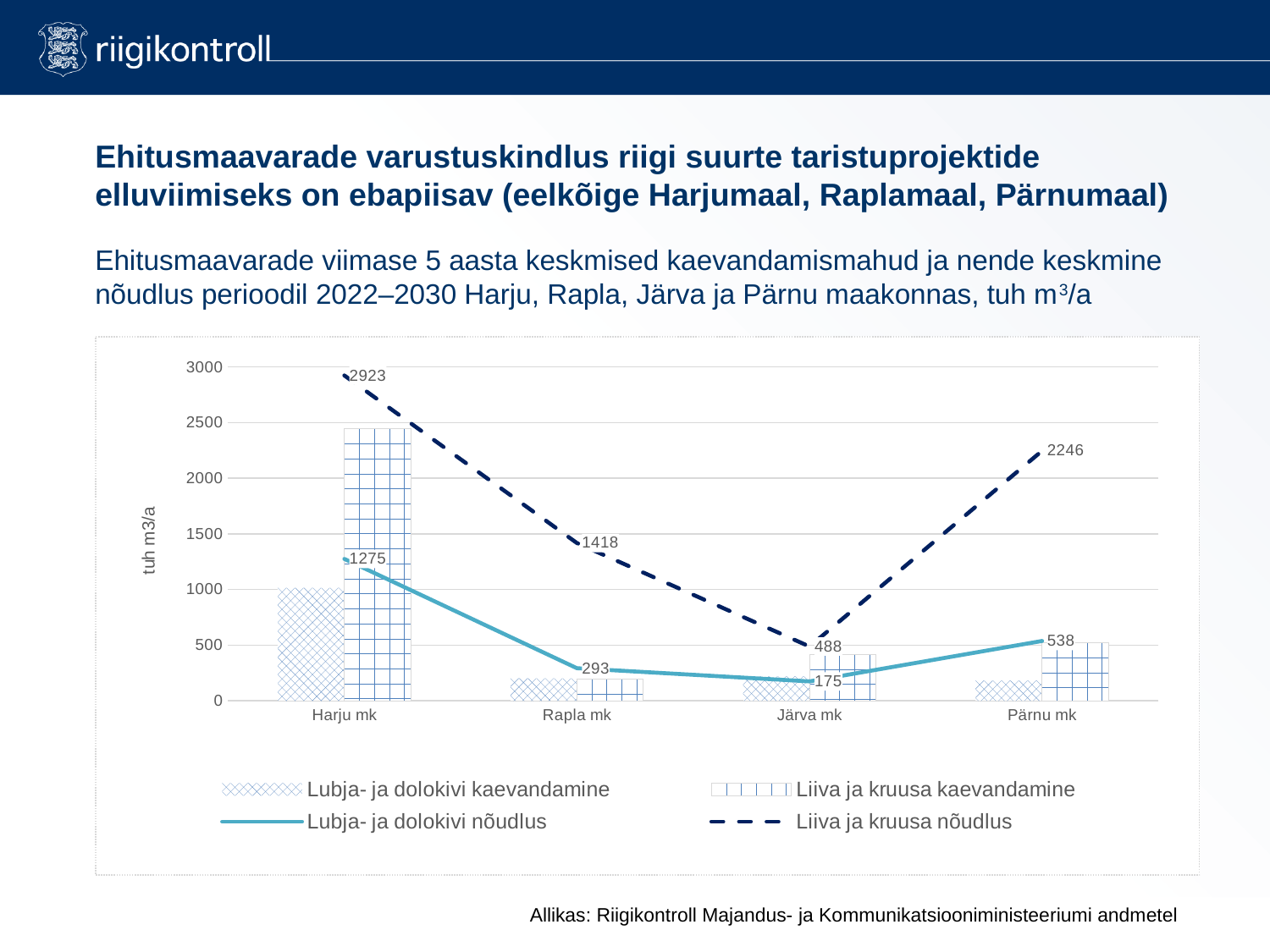
Is the Liiva ja kruusa kaevandamine bar for Harju mk greater or less than 2000? greater Which is larger for Pärnu mk: Liiva ja kruusa nõudlus or Lubja- ja dolokivi nõudlus? Liiva ja kruusa nõudlus What is the unit shown on the vertical axis? tuh m3/a Which county has the lowest Lubja- ja dolokivi nõudlus? Järva mk What is the value of Lubja- ja dolokivi nõudlus for Rapla mk? 293 What is the value of Liiva ja kruusa nõudlus for Pärnu mk? 2246 Which county has the highest Liiva ja kruusa nõudlus? Harju mk What is the value of Lubja- ja dolokivi nõudlus for Järva mk? 175 What is the value of Liiva ja kruusa nõudlus for Harju mk? 2923 How many series does the legend list? 4 What is the difference between Liiva ja kruusa nõudlus and Lubja- ja dolokivi nõudlus for Harju mk? 1648 How many counties are shown on the x axis? 4